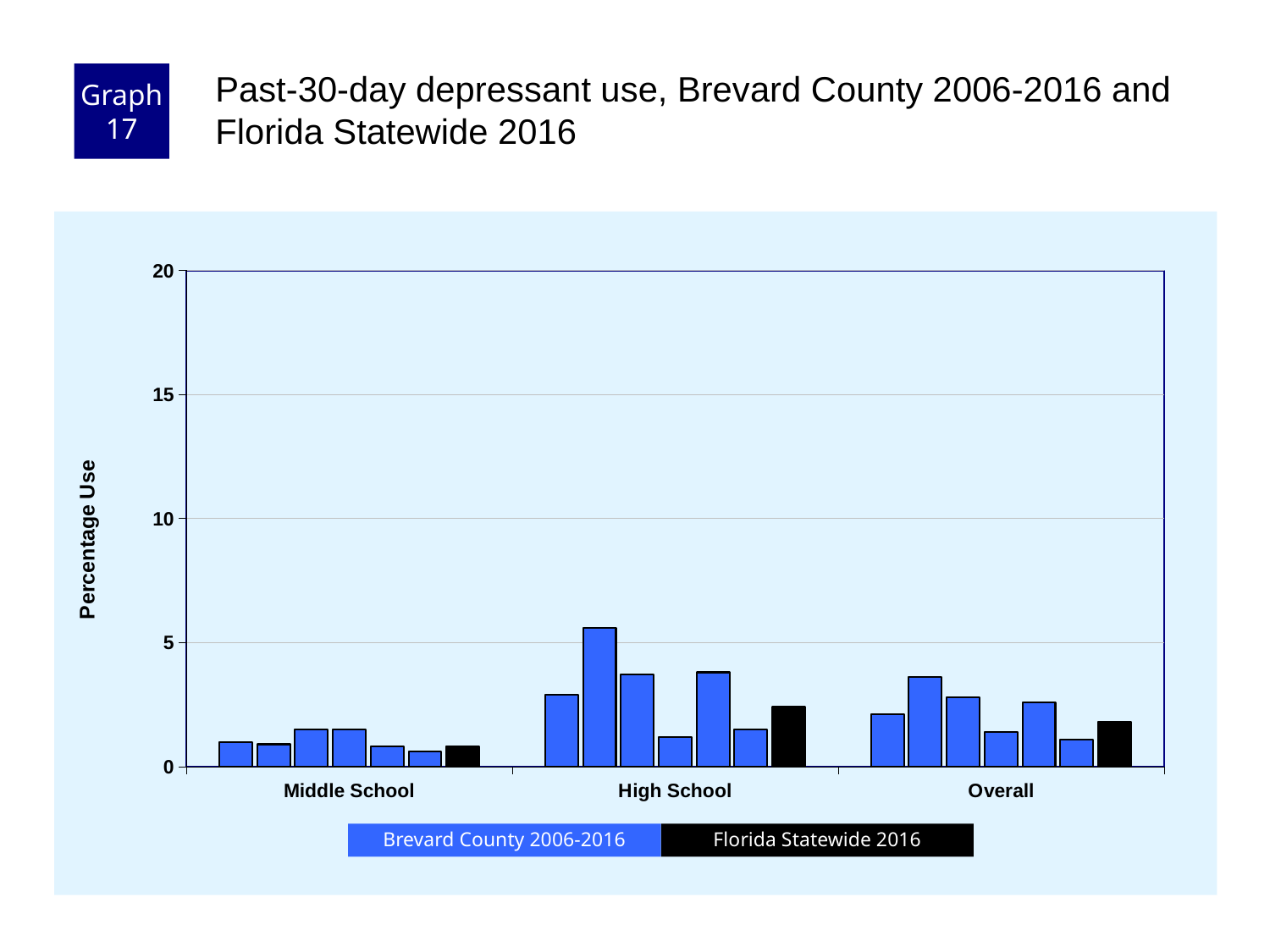
Is the tallest bar in the High School group greater or less than 5? greater How many series does the legend list? 2 Which is larger, the Florida Statewide 2016 value for High School or for Middle School? High School What kind of chart is shown on the slide? bar chart Which x-axis group contains the tallest bar on the chart? High School Which is larger, the Florida Statewide 2016 value for Overall or for Middle School? Overall Is the Florida Statewide 2016 value for High School greater or less than 5? less How many categories are shown along the x axis? 3 Is the Florida Statewide 2016 value for Middle School greater or less than 5? less What is the label on the y axis? Percentage Use How many bars are plotted in the High School group? 7 What colour represents Florida Statewide 2016 in the legend? black